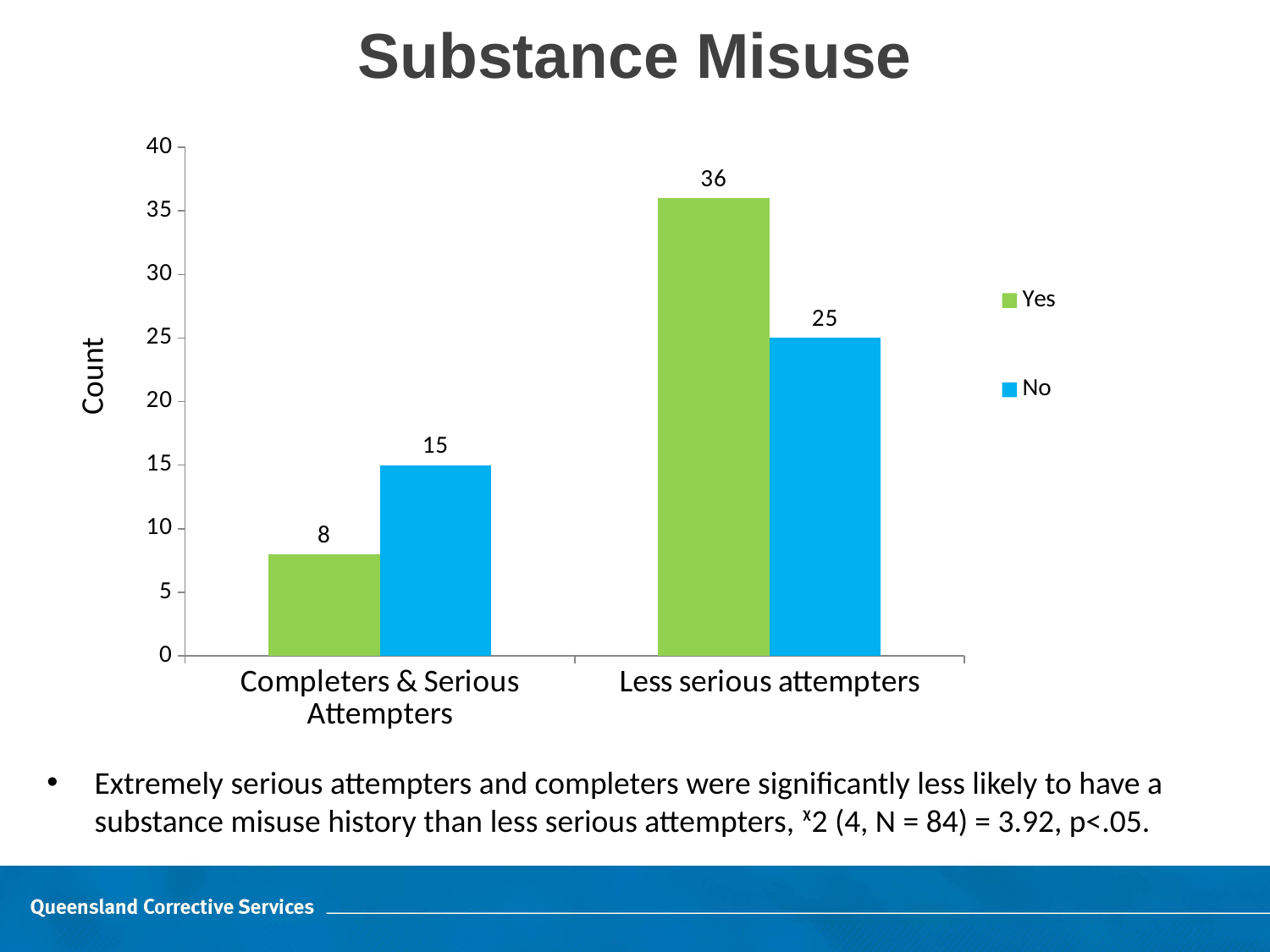
What type of chart is shown on the slide? Bar chart For Completers & Serious Attempters, is the 'Yes' count or the 'No' count larger? No Which group has the highest 'Yes' count? Less serious attempters What is the 'No' count for Less serious attempters? 25 What is the difference between the 'Yes' and 'No' counts for Less serious attempters? 11 Is the 'Yes' value for Less serious attempters greater or less than 30? greater What is the difference between the 'No' counts for Less serious attempters and Completers & Serious Attempters? 10 What is the 'Yes' count for Completers & Serious Attempters? 8 What is the 'Yes' count for Less serious attempters? 36 Which group has the lowest 'No' count? Completers & Serious Attempters How many series does the legend list? 2 How many categories are shown on the x axis? 2